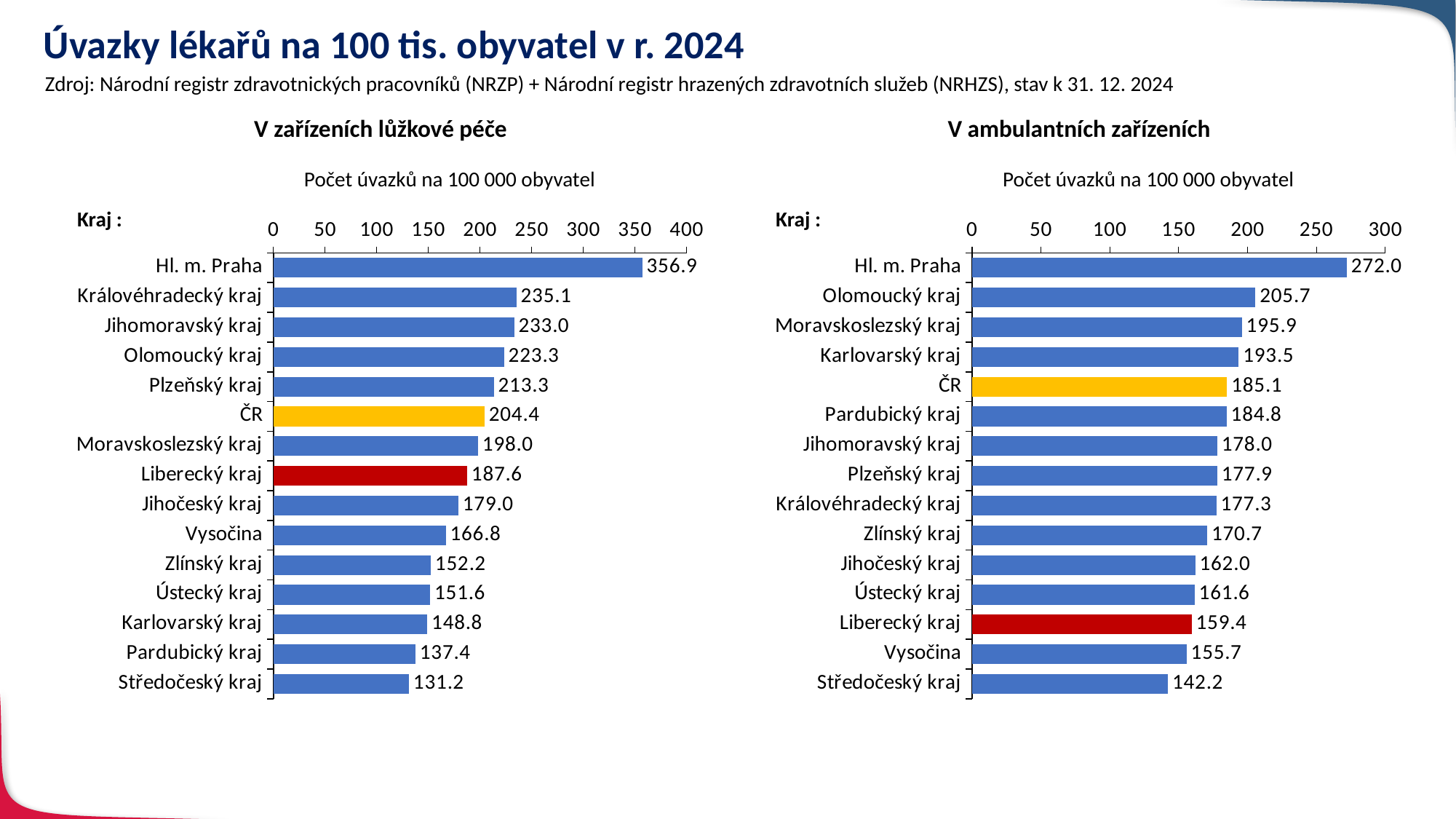
In the chart 'V zařízeních lůžkové péče', what is the difference between the values for Hl. m. Praha and Středočeský kraj? 225.7 In the chart 'V ambulantních zařízeních', what is the difference between the values for Olomoucký kraj and Liberecký kraj? 46.3 In the chart 'V zařízeních lůžkové péče', which category has the highest value? Hl. m. Praha In the chart 'V zařízeních lůžkové péče', is the value for Plzeňský kraj greater or less than 200? greater In the chart 'V ambulantních zařízeních', what is the value for ČR? 185.1 In the chart 'V ambulantních zařízeních', which bar is coloured red? Liberecký kraj In the chart 'V zařízeních lůžkové péče', what is the value for Liberecký kraj? 187.6 What kind of chart is 'V zařízeních lůžkové péče'? bar chart How many categories are plotted in the chart 'V ambulantních zařízeních'? 15 In the chart 'V ambulantních zařízeních', which category has the lowest value? Středočeský kraj In the chart 'V ambulantních zařízeních', which is larger: the value for Karlovarský kraj or the value for Jihomoravský kraj? Karlovarský kraj In the chart 'V zařízeních lůžkové péče', what is the value for Pardubický kraj? 137.4